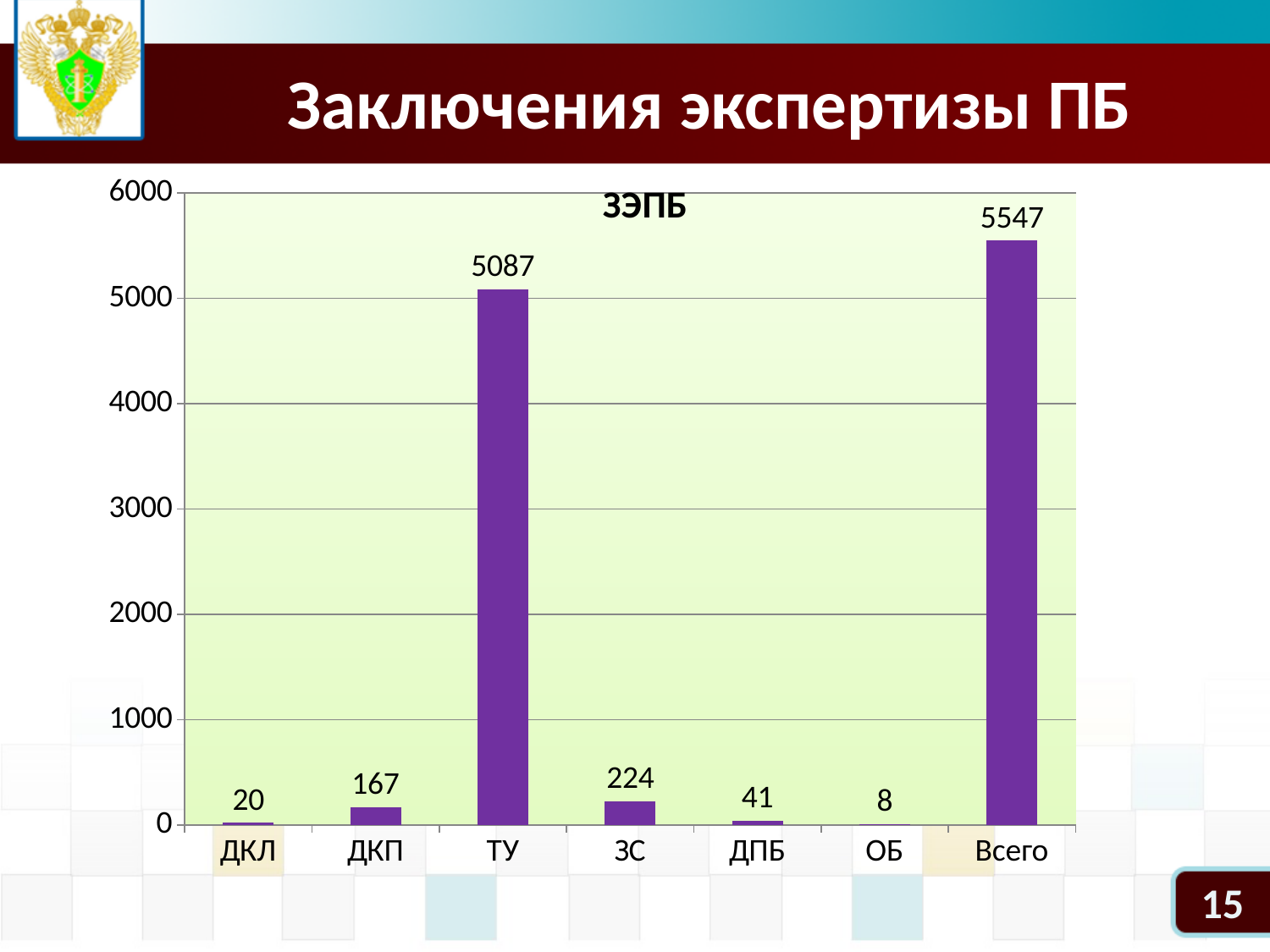
What is the value for Всего? 5547 What is the difference between the values for ЗС and ДКП? 57 Which category has the lowest value? ОБ What is the title of the chart? ЗЭПБ What is the value for ОБ? 8 What is the value for ТУ? 5087 How many categories are shown on the x axis? 7 What kind of chart is shown on the slide? bar chart What is the difference between the values for Всего and ТУ? 460 Which is larger, the value for ДПБ or the value for ДКЛ? ДПБ Which category has the highest value? Всего What is the value for ДКП? 167